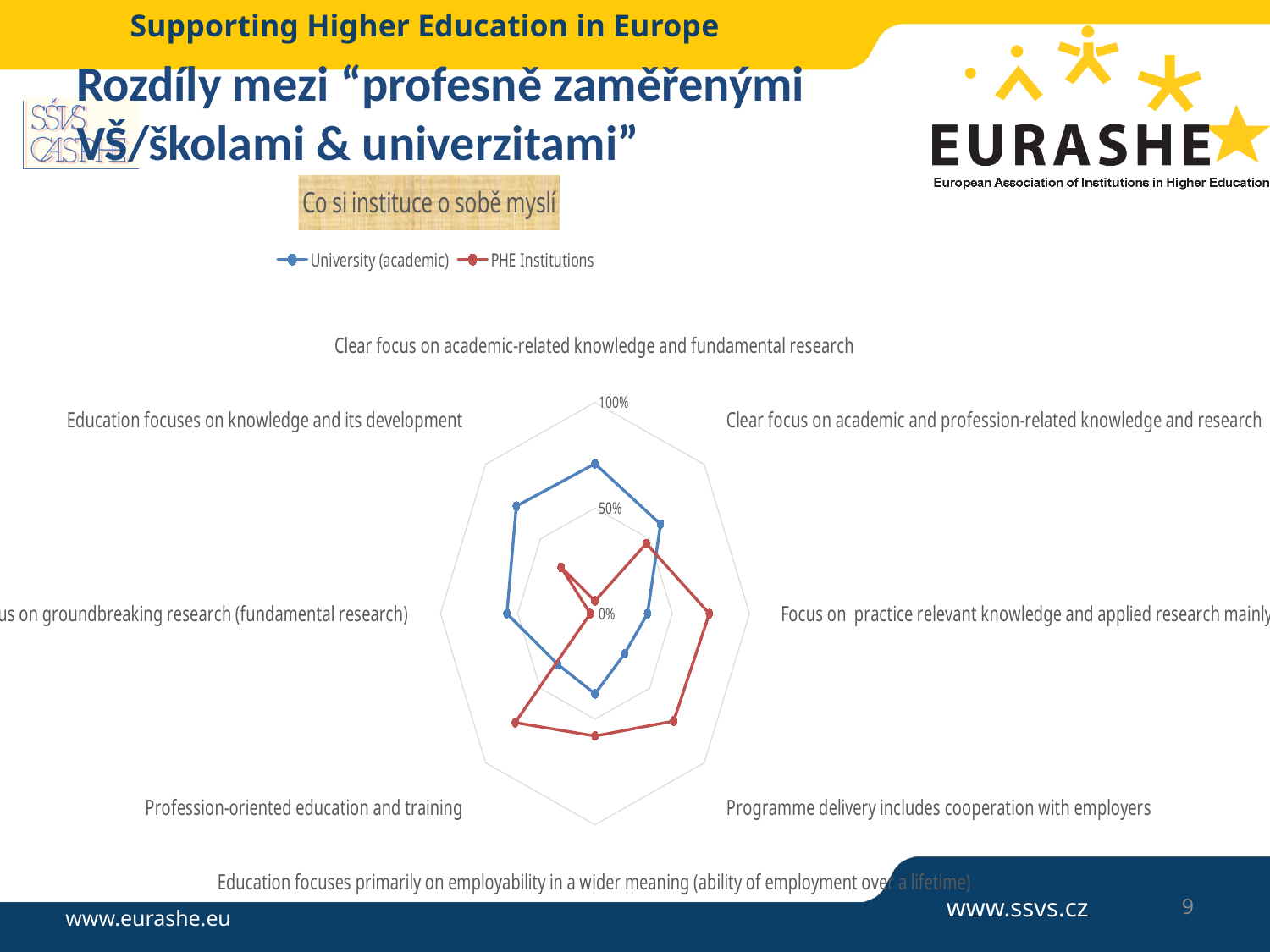
What kind of chart is shown on the slide? Radar chart Is the University (academic) value for "Programme delivery includes cooperation with employers" greater or less than 50%? less Is the University (academic) value for "Clear focus on academic-related knowledge and fundamental research" greater or less than 50%? greater Which series is drawn in red on the chart? PHE Institutions For "Programme delivery includes cooperation with employers", which series has the larger value, University (academic) or PHE Institutions? PHE Institutions Is the PHE Institutions value for "Profession-oriented education and training" greater or less than 50%? greater For "Education focuses on knowledge and its development", which series has the larger value, University (academic) or PHE Institutions? University (academic) How many categories (axes) does the radar chart have? 8 How many series does the chart legend list? 2 What is the title shown above the chart? Co si instituce o sobě myslí For "Focus on practice relevant knowledge and applied research mainly", which series has the larger value, University (academic) or PHE Institutions? PHE Institutions